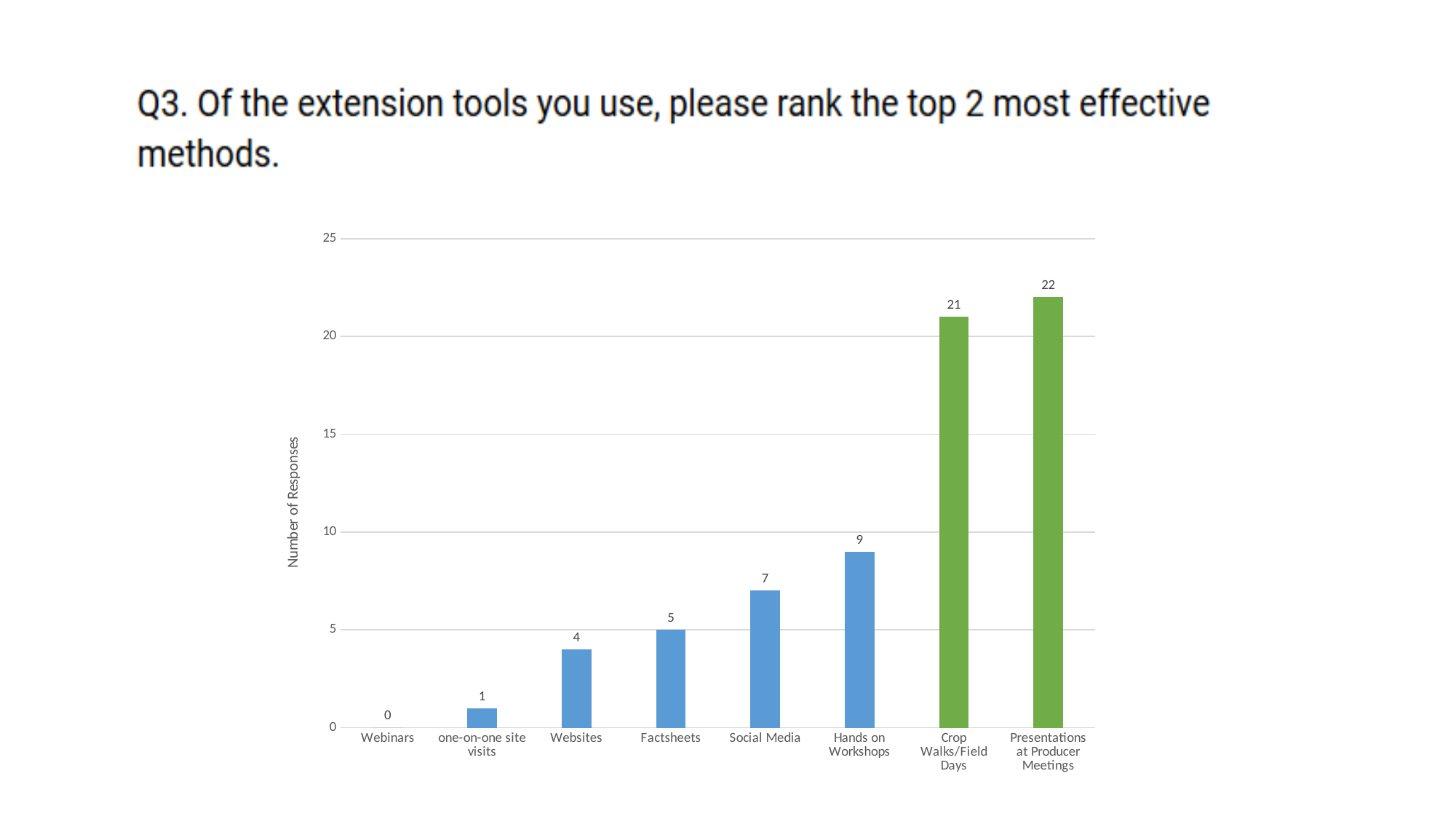
What is the number of responses for Social Media? 7 What is the label of the y axis? Number of Responses What is the difference in responses between Presentations at Producer Meetings and Hands on Workshops? 13 How many extension tool categories are shown on the x axis? 8 Which has more responses, Factsheets or Websites? Factsheets Do the values rise or fall moving from left to right along the x axis? Rise What is the number of responses for Crop Walks/Field Days? 21 Is the value for Hands on Workshops greater or less than 10? less Which extension tool has the lowest number of responses? Webinars What kind of chart is shown on the slide? Bar chart What is the number of responses for Webinars? 0 Which extension tool has the highest number of responses? Presentations at Producer Meetings